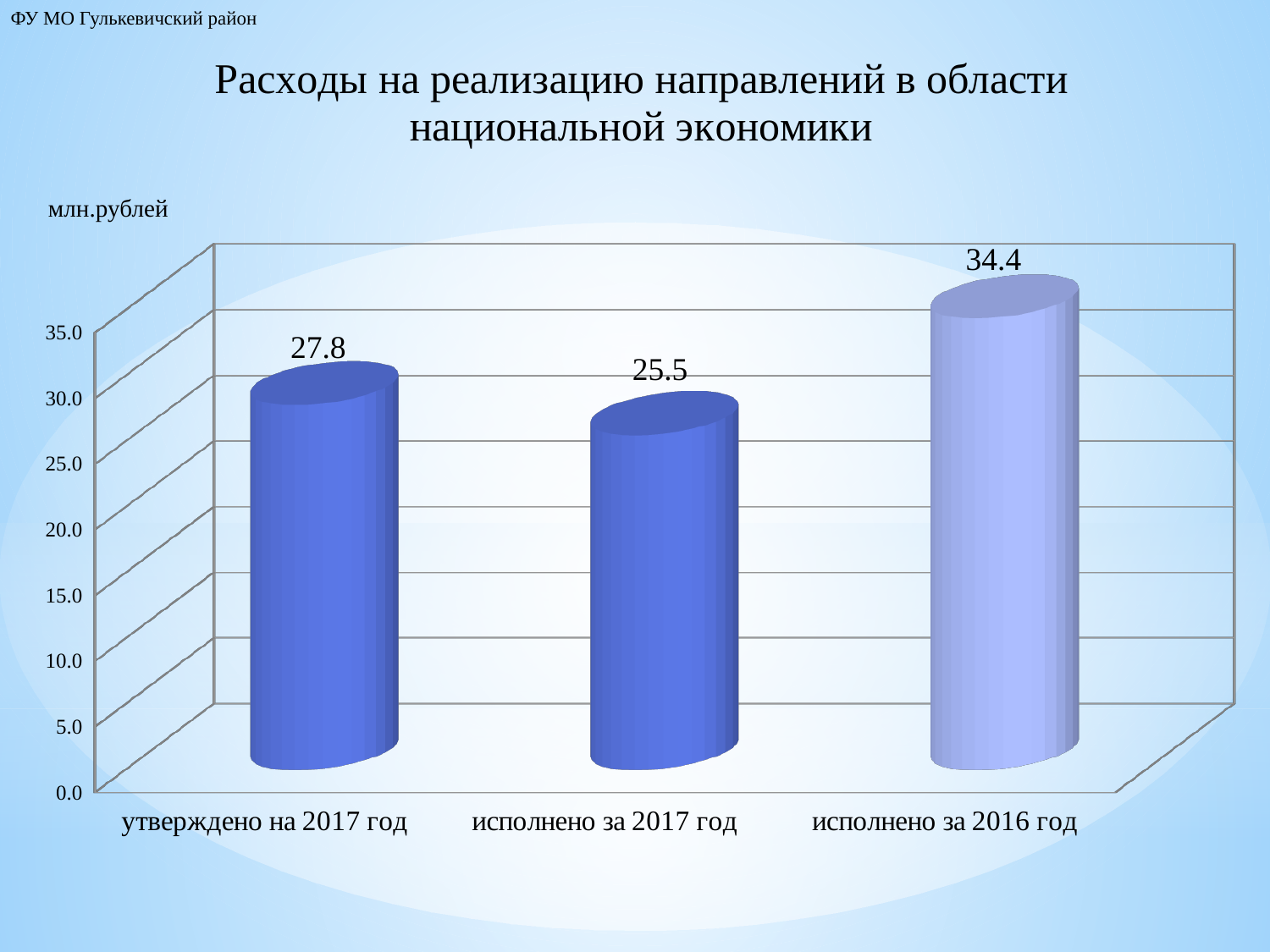
What is the value for 'исполнено за 2017 год'? 25.5 What unit is indicated for the values in the chart? млн.рублей What is the value for 'исполнено за 2016 год'? 34.4 Which is larger: the value for 'утверждено на 2017 год' or 'исполнено за 2017 год'? утверждено на 2017 год What is the difference between the values for 'исполнено за 2016 год' and 'исполнено за 2017 год'? 8.9 What is the difference between the values for 'утверждено на 2017 год' and 'исполнено за 2017 год'? 2.3 How many categories are shown in the chart? 3 Is the value for 'исполнено за 2016 год' greater or less than 30.0? greater What is the value for 'утверждено на 2017 год'? 27.8 What kind of chart is shown on the slide? bar chart Which category has the lowest value? исполнено за 2017 год Which category has the highest value? исполнено за 2016 год